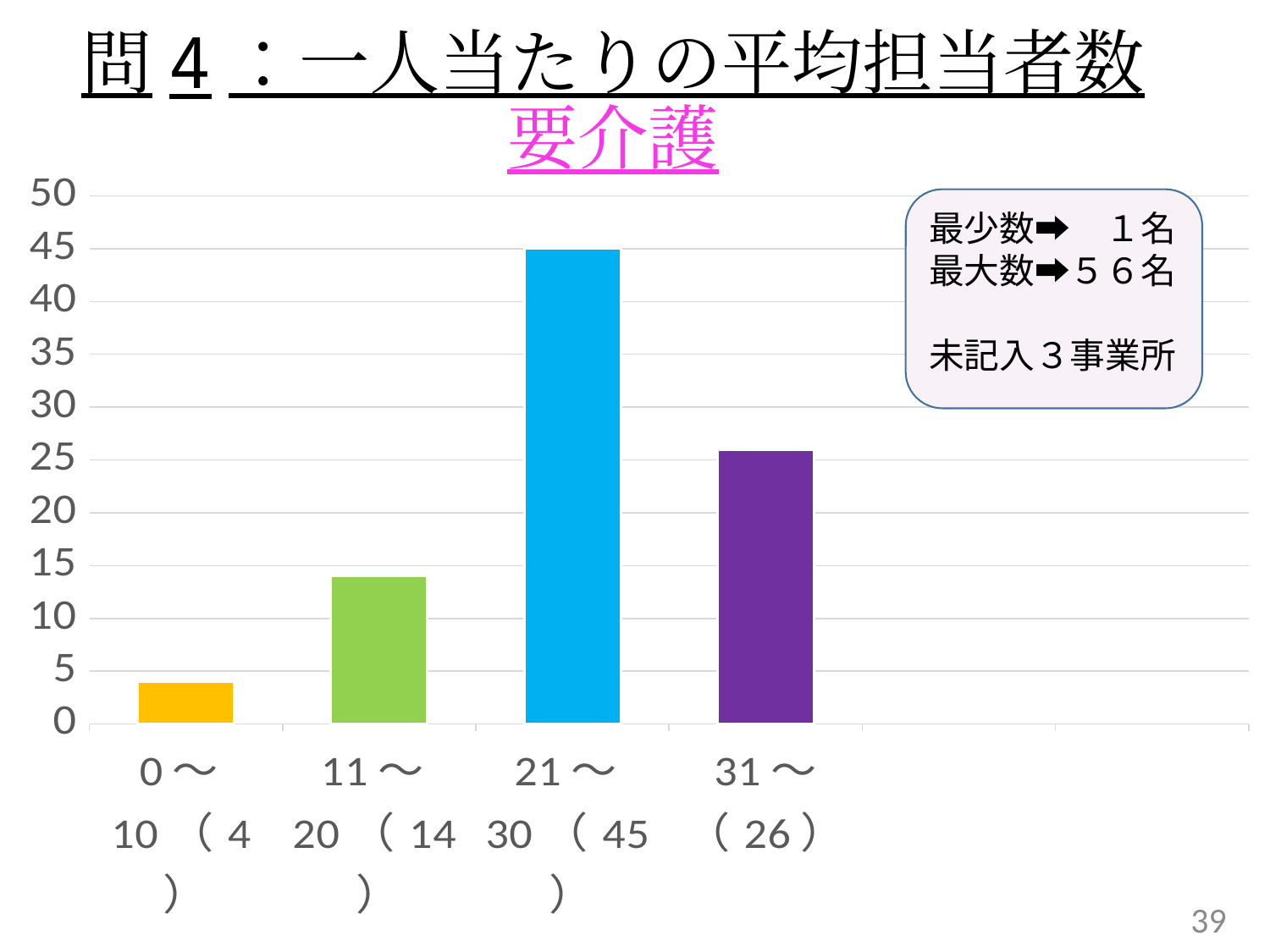
What is the difference between the values for 21～30 and 31～? 19 Which is larger, the value for 11～20 or the value for 31～? 31～ What is the value for the 21～30 category? 45 What is the subtitle shown in pink below the main title? 要介護 What kind of chart is shown on the slide? bar chart Is the value for the 21～30 category greater or less than 40? greater What is the value for the 0～10 category? 4 What is the value for the 31～ category? 26 Which category has the lowest value? 0～10 What is the value for the 11～20 category? 14 Which category has the highest value? 21～30 How many categories (bars) does the chart show? 4